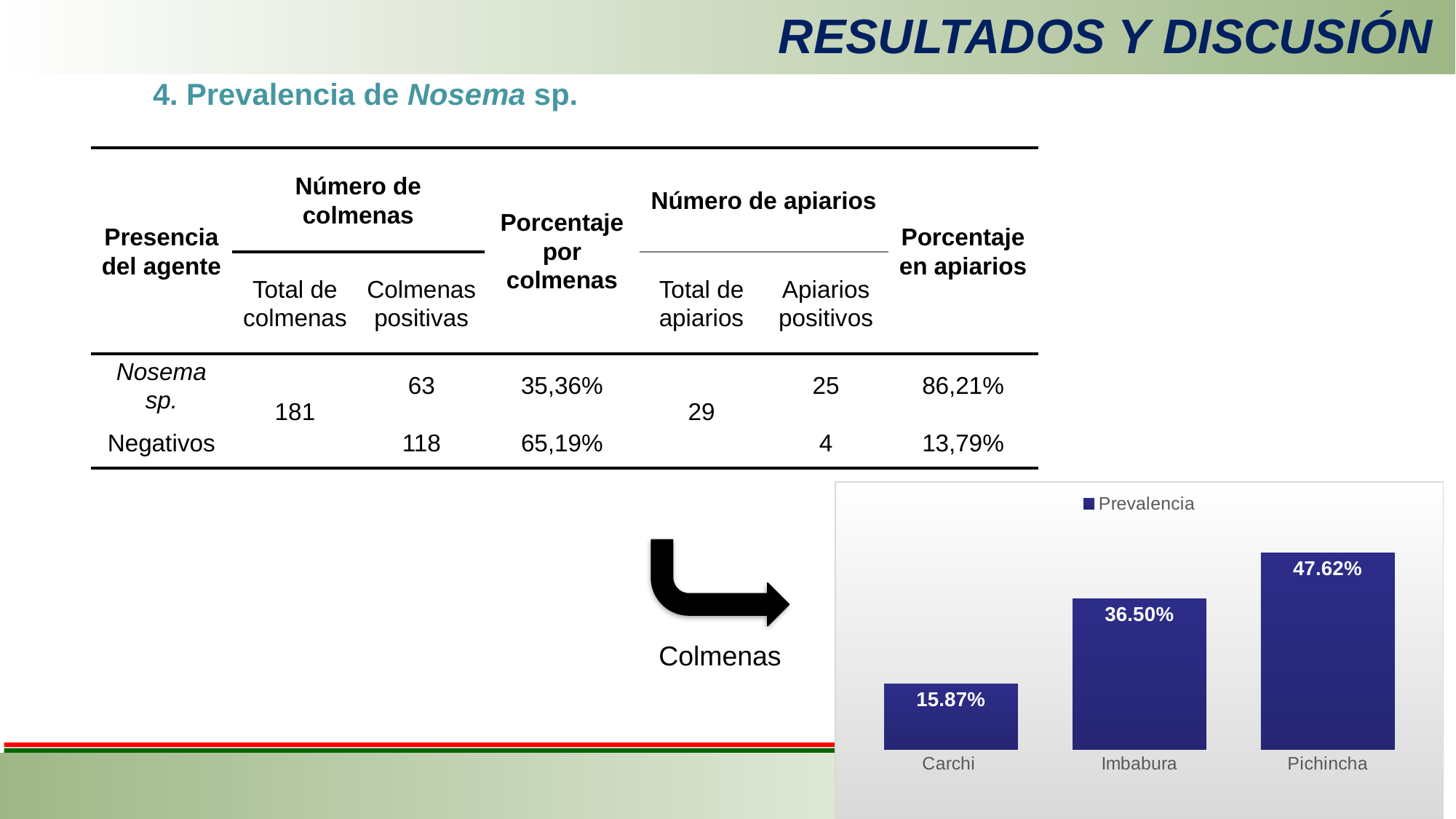
What is the Prevalencia value for Pichincha in the bar chart? 47.62% Which province has the lowest Prevalencia in the bar chart? Carchi Which has a higher Prevalencia in the bar chart, Imbabura or Pichincha? Pichincha Which province has the highest Prevalencia in the bar chart? Pichincha What is the Prevalencia value for Imbabura in the bar chart? 36.50% What is the difference in Prevalencia between Pichincha and Carchi in the bar chart? 31.75% What is the Prevalencia value for Carchi in the bar chart? 15.87% How many series does the legend of the bar chart list? 1 What type of chart is shown on the slide? Bar chart How many provinces are shown in the bar chart? 3 Do the Prevalencia values rise or fall from Carchi to Pichincha along the x axis? Rise What is the difference in Prevalencia between Imbabura and Carchi in the bar chart? 20.63%